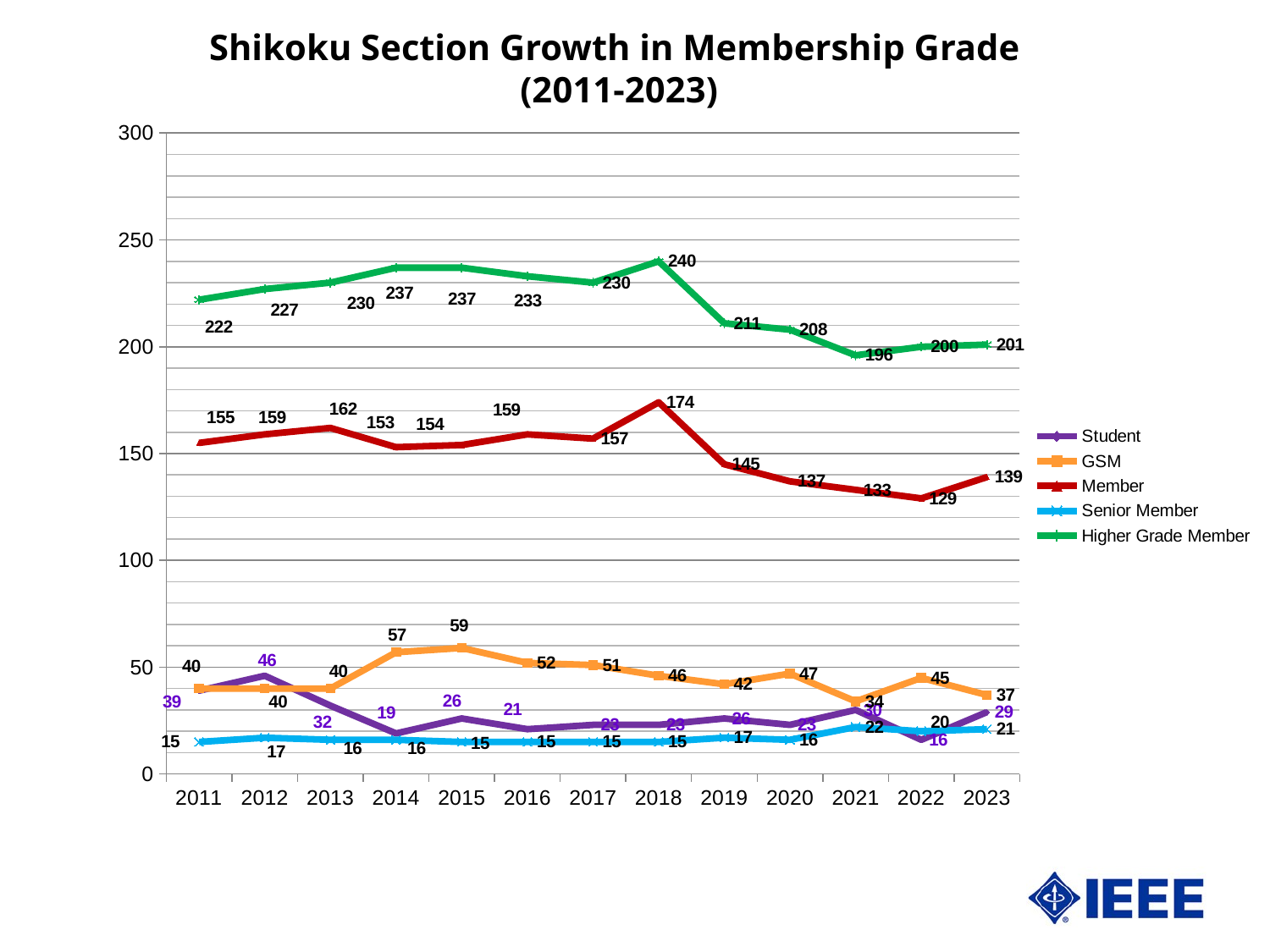
In which year is the Member value lowest? 2022 Does the Higher Grade Member line rise or fall from 2018 to 2021? fall What is the title of the chart? Shikoku Section Growth in Membership Grade (2011-2023) What is the value for GSM in 2015? 59 What is the value for Higher Grade Member in 2018? 240 How many series does the legend list? 5 What is the difference between the Member values in 2018 and 2019? 29 How many years are plotted along the x axis? 13 Which is larger in 2014, the GSM value or the Student value? GSM What kind of chart is shown on the slide? line chart In which year is the Higher Grade Member value highest? 2018 What is the value for Member in 2022? 129